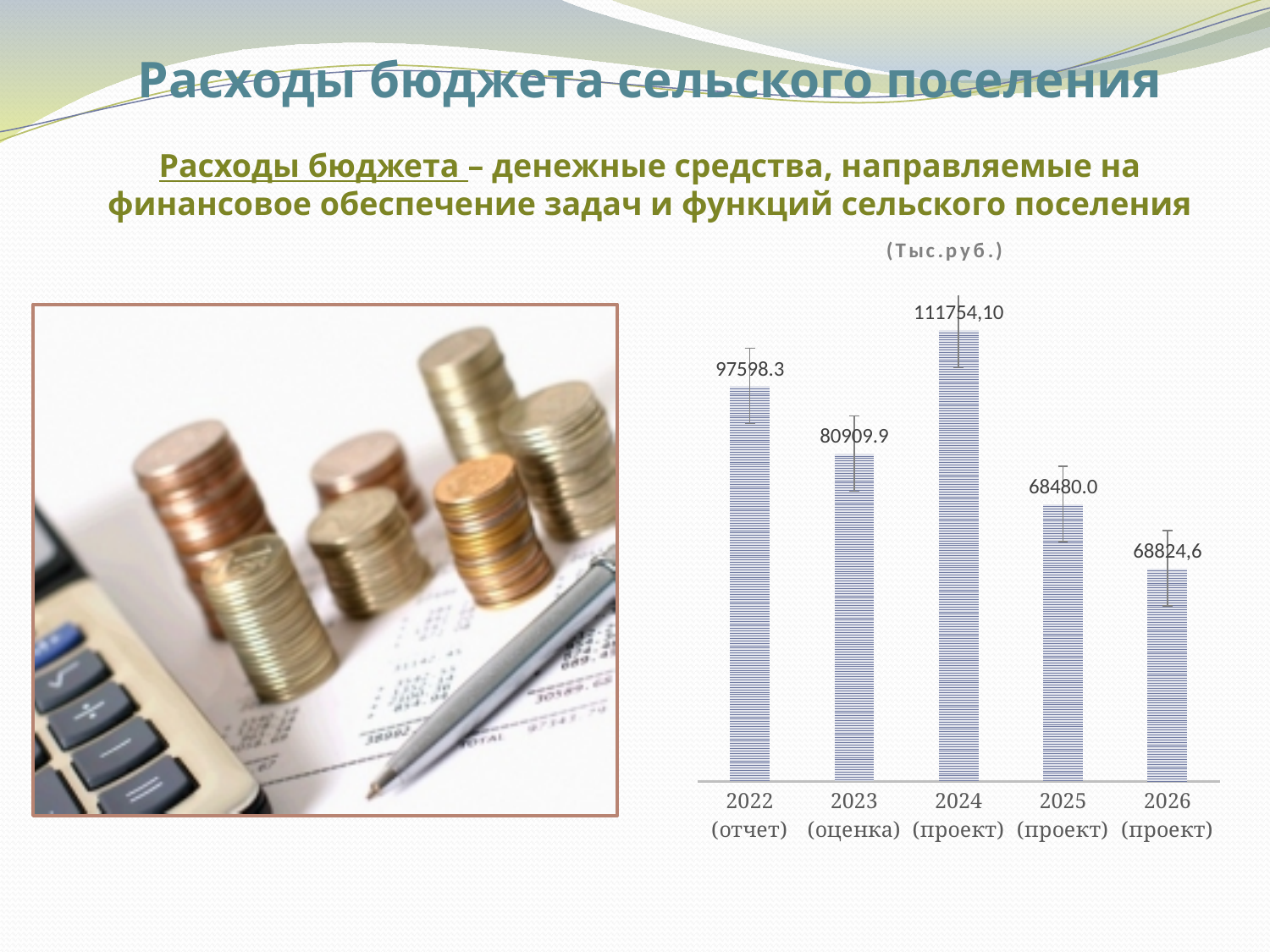
Which is larger, the value for 2022 (отчет) or the value for 2023 (оценка)? 2022 (отчет) What is the value for 2022 (отчет)? 97598.3 Which year has the highest value on the chart? 2024 (проект) How many categories (years) are shown on the chart? 5 What is the difference between the values for 2024 (проект) and 2025 (проект)? 43274.10 What type of chart is shown on the slide? bar chart What is the value for 2025 (проект)? 68480.0 What is the value for 2023 (оценка)? 80909.9 What is the difference between the values for 2022 (отчет) and 2023 (оценка)? 16688.4 What is the value for 2026 (проект)? 68824,6 What is the value for 2024 (проект)? 111754,10 What unit is given in the chart title? Тыс.руб.